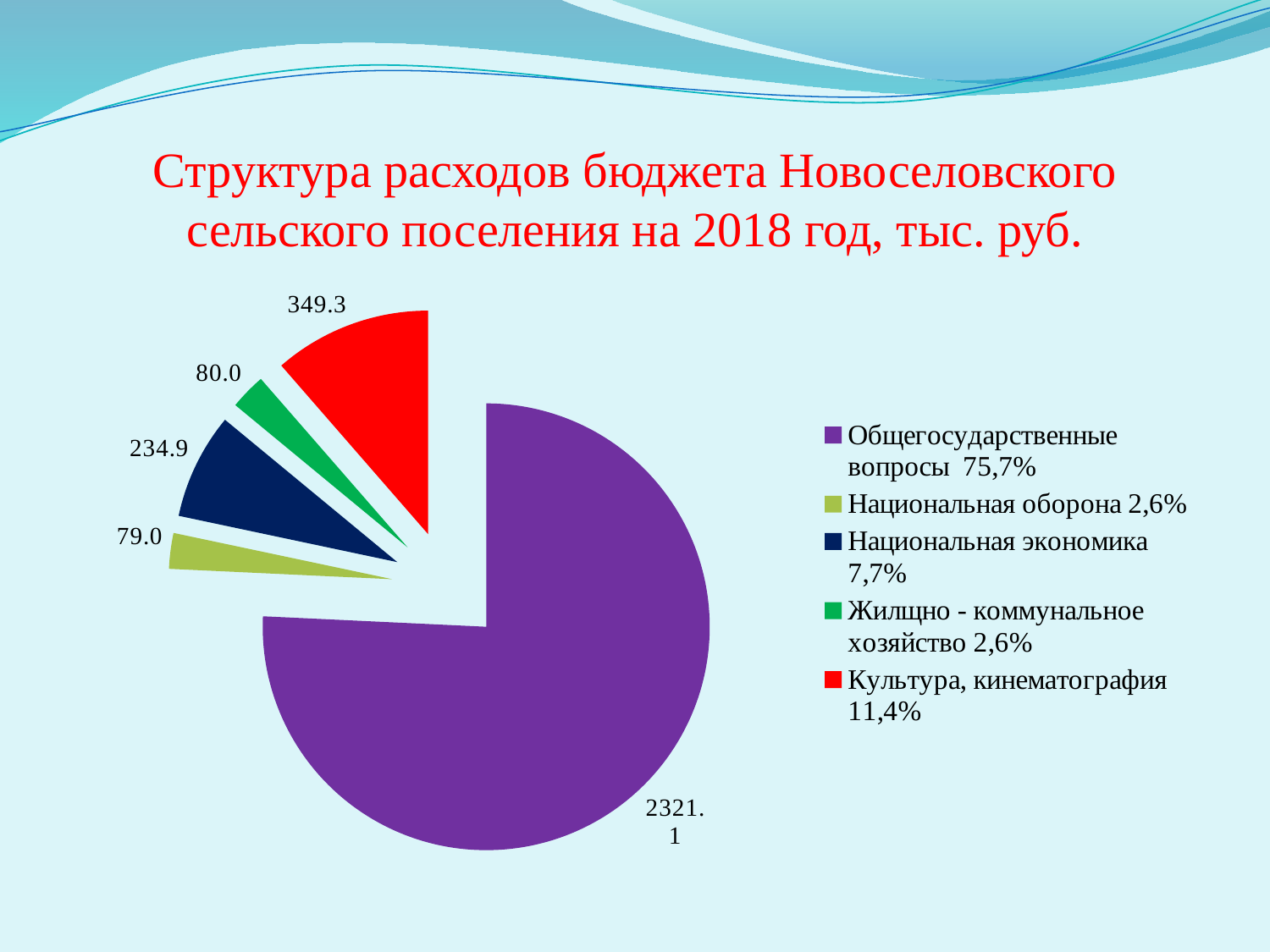
How many categories does the legend list? 5 Which is larger, the value for Национальная экономика or the value for Культура, кинематография? Культура, кинематография What is the value for Национальная экономика? 234.9 Which category has the largest slice of the pie? Общегосударственные вопросы What kind of chart is shown on the slide? Pie chart What is the value for Жилищно-коммунальное хозяйство? 80.0 What share of the pie does Культура, кинематография represent? 11,4% What is the difference between the values for Культура, кинематография and Национальная экономика? 114.4 Which category has the smallest slice of the pie? Национальная оборона What is the value for Национальная оборона? 79.0 What is the value for Культура, кинематография? 349.3 What is the value for Общегосударственные вопросы? 2321.1